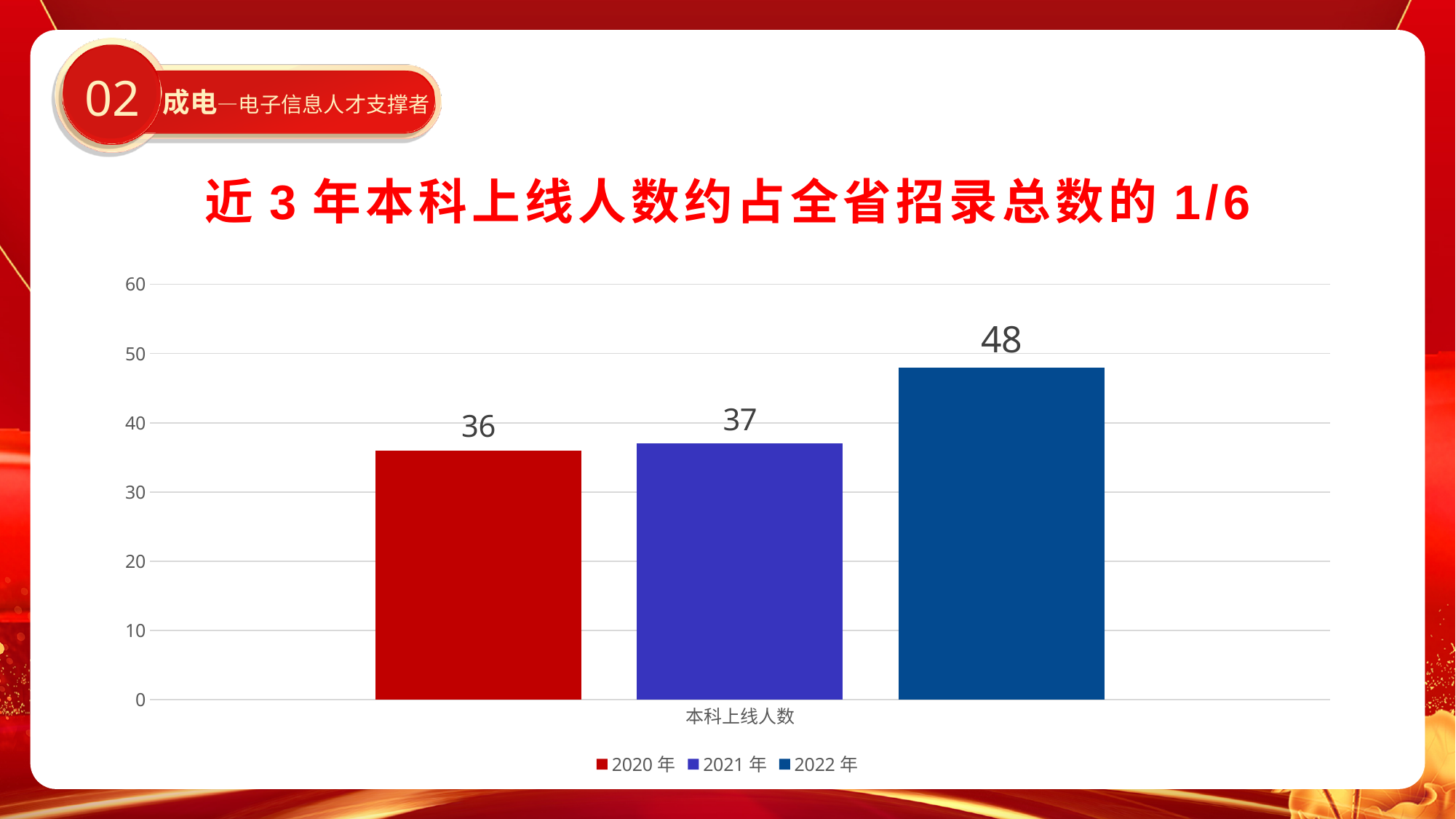
How many series does the legend list? 3 Is the value for 2022 年 greater or less than 40? greater What is the difference between the values for 2022 年 and 2020 年? 12 What is the value for 2022 年 in the chart? 48 What is the difference between the values for 2022 年 and 2021 年? 11 Which year has the highest value in the chart? 2022 年 What kind of chart is shown on the slide? bar chart What is the value for 2021 年 in the chart? 37 What is the category label shown on the x axis of the chart? 本科上线人数 Which year has the lowest value in the chart? 2020 年 What is the value for 2020 年 in the chart? 36 Which is larger, the value for 2022 年 or the value for 2020 年? 2022 年